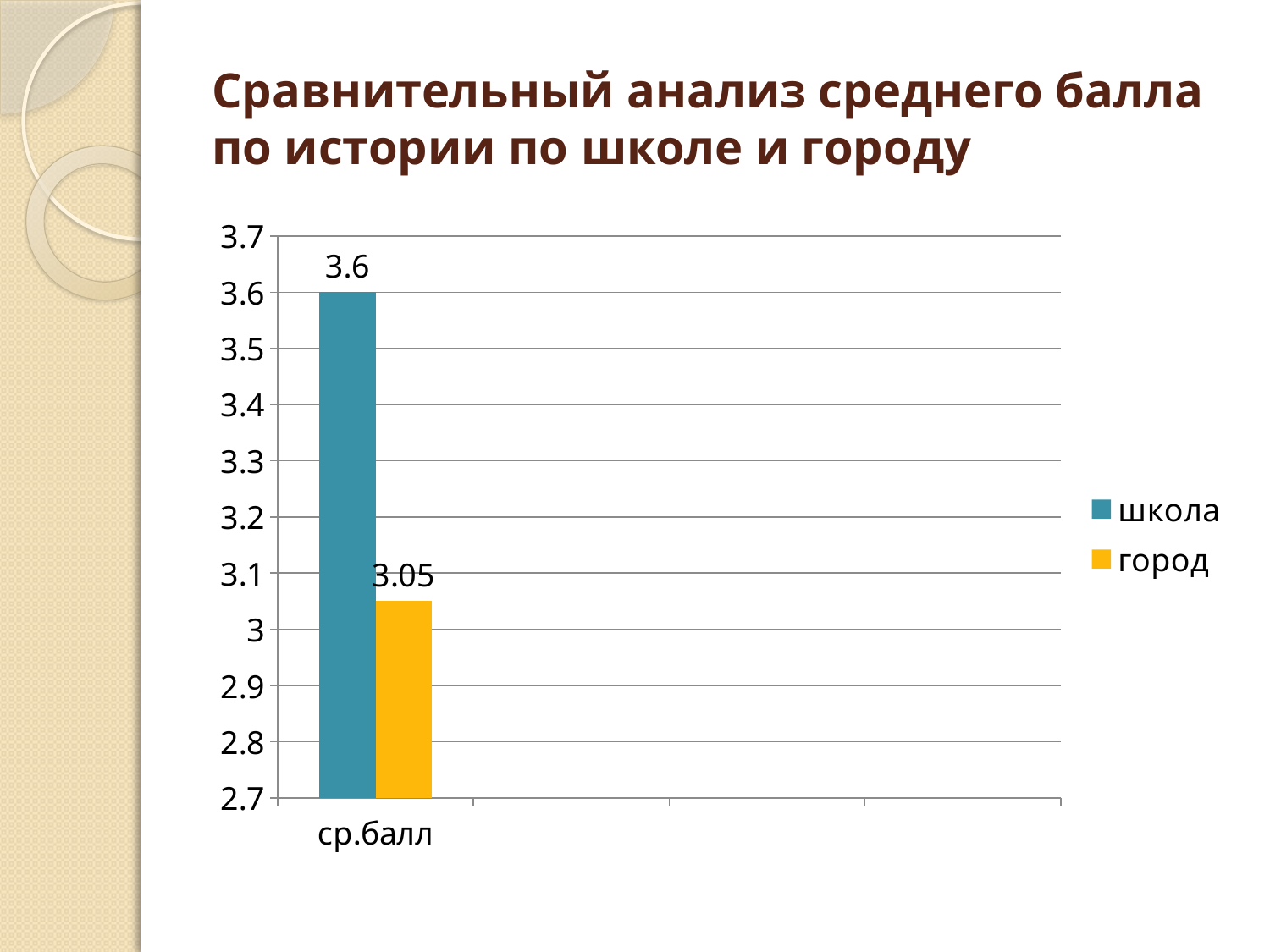
What is the value for город in the ср.балл category? 3.05 What kind of chart is shown on the slide? bar chart What is the label of the category on the x axis? ср.балл Which series has the lowest value? город Which series has the higher value: школа or город? школа Is the value for школа greater or less than 3.5? greater What is the difference between the школа value and the город value? 0.55 What colour is the bar for город? yellow Is the value for город greater or less than 3.1? less What is the value for школа in the ср.балл category? 3.6 How many categories are shown on the x axis? 1 How many series does the legend list? 2